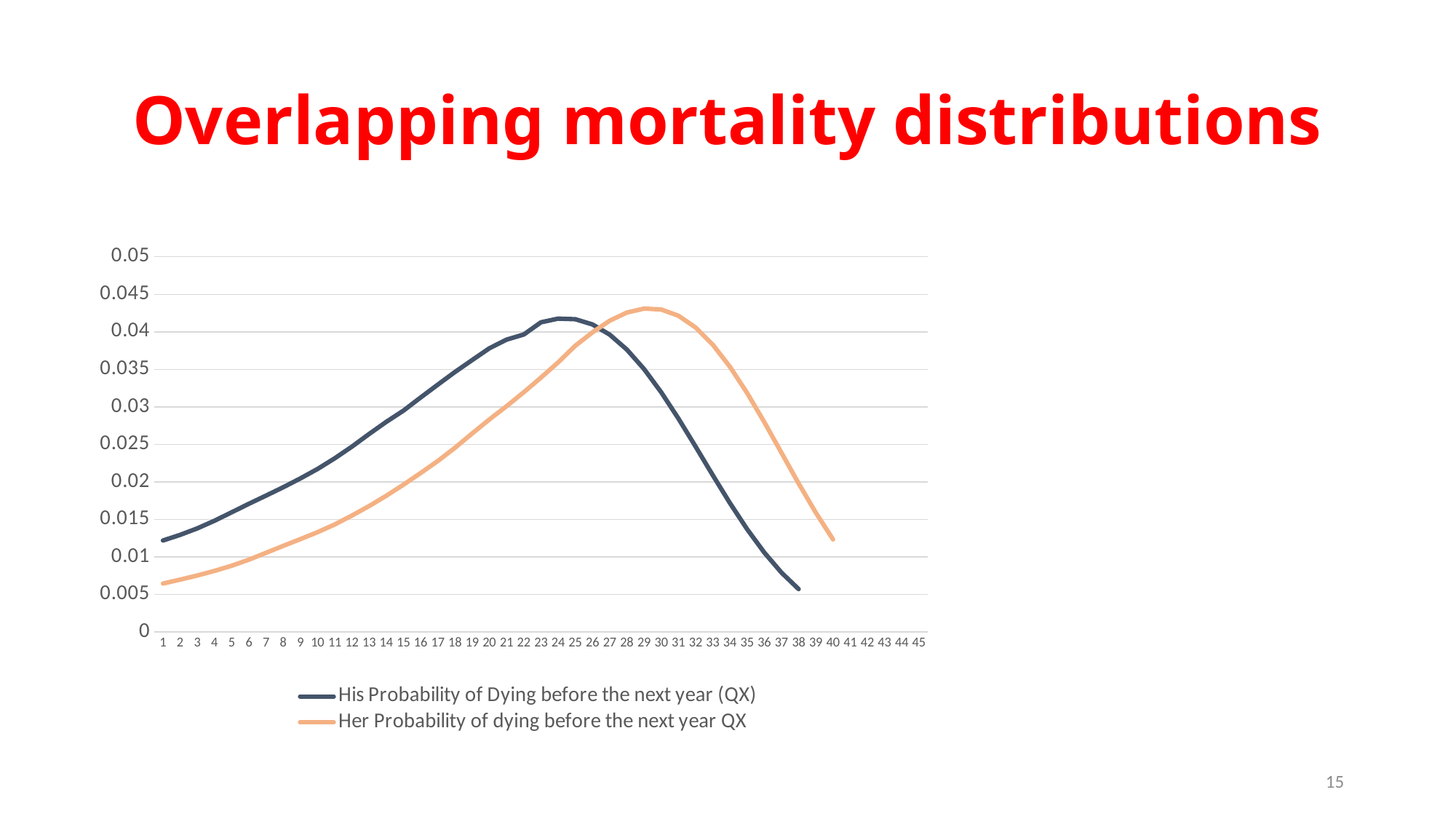
Does 'His Probability of Dying before the next year (QX)' rise or fall from x = 24 to x = 38? fall Which series is drawn in the orange line? Her Probability of dying before the next year QX What kind of chart is shown on the slide? line chart At x = 35, which series has the larger value? Her Probability of dying before the next year QX Is the value of 'His Probability of Dying before the next year (QX)' at x = 30 greater or less than 0.035? less At x = 10, which series has the larger value? His Probability of Dying before the next year (QX) Is the value of 'Her Probability of dying before the next year QX' at x = 1 greater or less than 0.01? less Is the peak value of 'Her Probability of dying before the next year QX' greater or less than 0.04? greater What is the title of the slide above the chart? Overlapping mortality distributions How many tick labels are shown on the x axis? 45 How many series does the legend list? 2